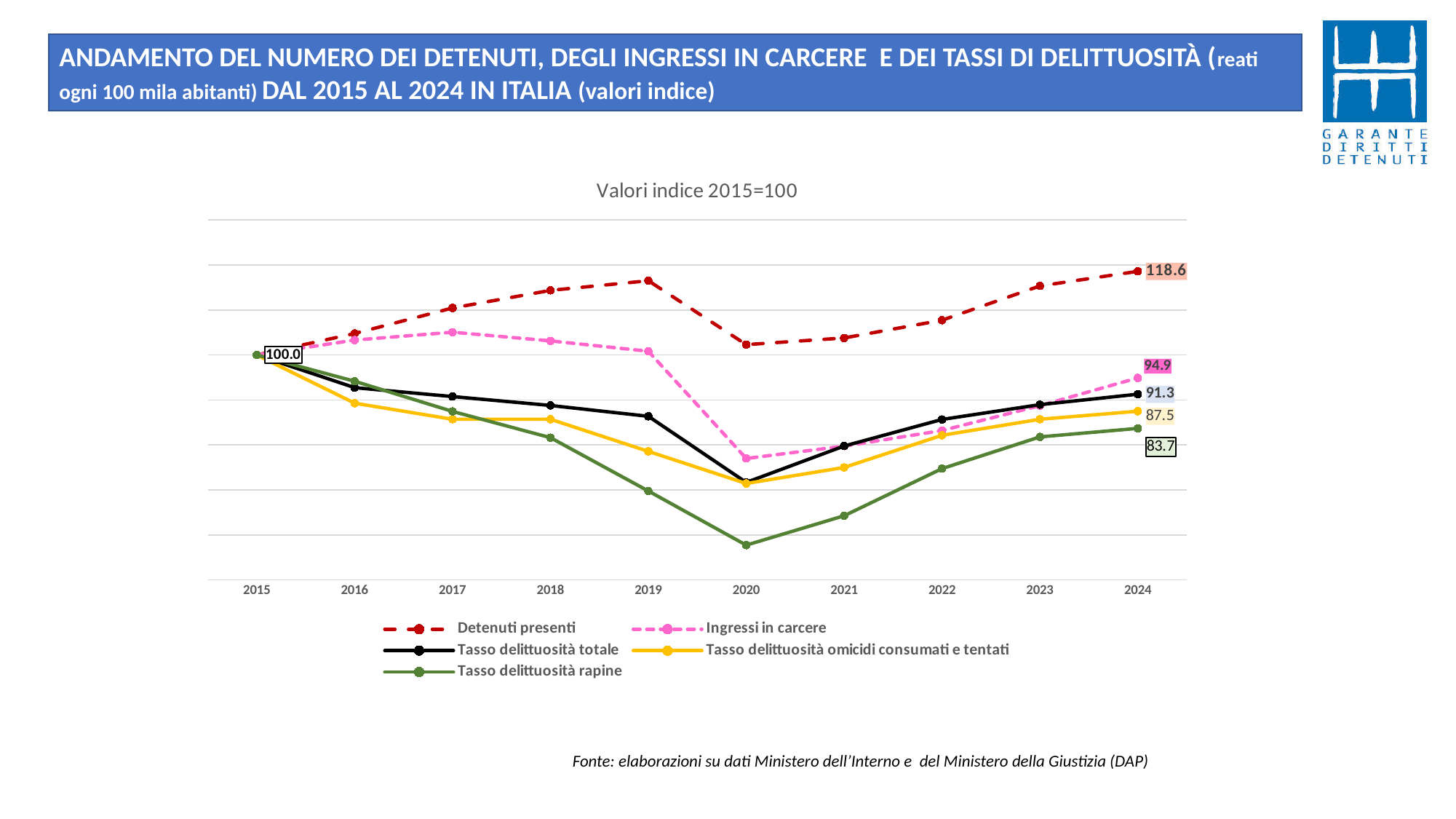
What is the index value for Tasso delittuosità rapine in 2024? 83.7 How many years are plotted along the x axis? 10 Which is larger in 2024: Tasso delittuosità totale or Tasso delittuosità omicidi consumati e tentati? Tasso delittuosità totale Is the value for Tasso delittuosità rapine in 2020 greater or less than 100? less Which series has the highest index value in 2024? Detenuti presenti Does the Detenuti presenti series rise or fall overall from 2015 to 2024? rise Which series has the lowest index value in 2024? Tasso delittuosità rapine What is the difference between the 2024 values of Detenuti presenti and Ingressi in carcere? 23.7 What is the index value for Ingressi in carcere in 2024? 94.9 How many series does the legend list? 5 What is the index value for Detenuti presenti in 2024? 118.6 What kind of chart is shown on the slide? line chart